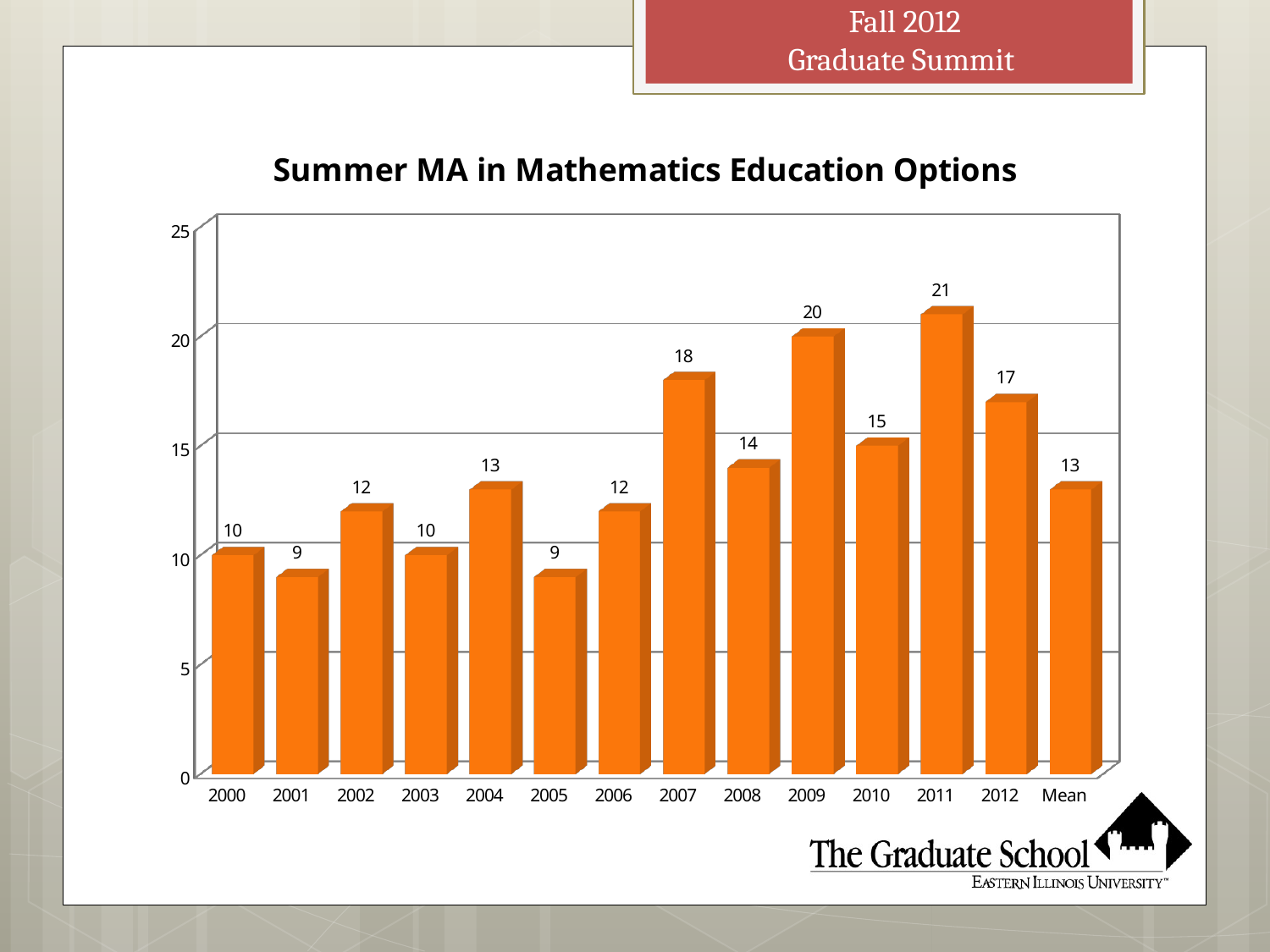
What kind of chart is shown on the slide? bar chart Is the value for 2010 greater or less than 10? greater Which year has the highest value? 2011 What is the difference between the values for 2011 and 2005? 12 Which is larger, the value for 2009 or the value for 2012? 2009 What is the title of the chart? Summer MA in Mathematics Education Options What is the value for the Mean bar? 13 What is the value for 2007? 18 What is the difference between the values for 2012 and 2002? 5 What is the value for 2003? 10 How many bars are shown in the chart? 14 Do the values generally rise or fall from 2005 to 2009? rise